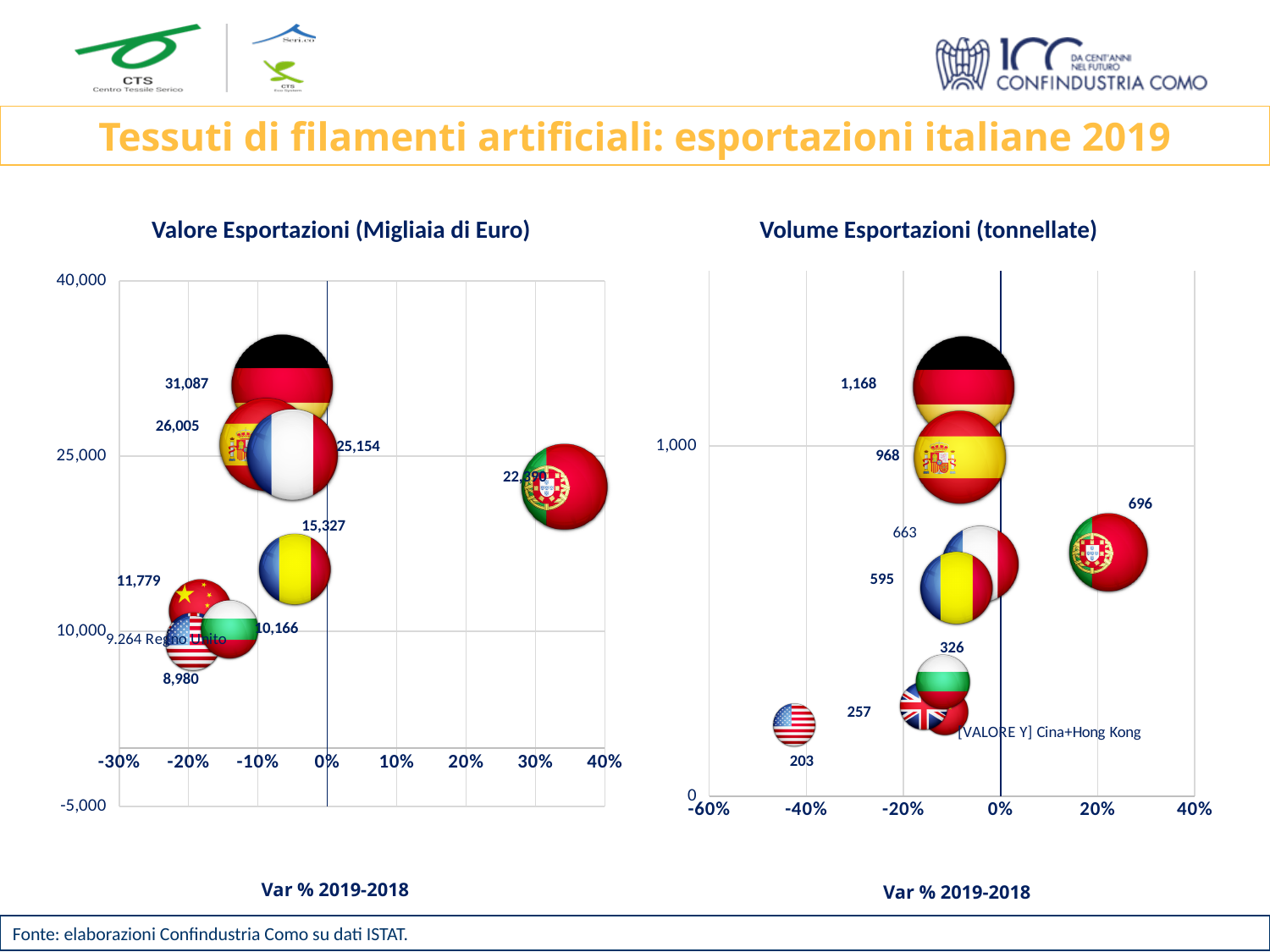
In the 'Volume Esportazioni (tonnellate)' chart, what is the highest labelled value? 1,168 What kind of chart is the 'Valore Esportazioni (Migliaia di Euro)' chart? Bubble chart In the 'Valore Esportazioni (Migliaia di Euro)' chart, what value is labelled for Regno Unito? 9.264 In the 'Valore Esportazioni (Migliaia di Euro)' chart, is the x-axis position of the bubble labelled 22,390 greater or less than 20%? greater In the 'Valore Esportazioni (Migliaia di Euro)' chart, what is the lowest labelled value? 8,980 In the 'Valore Esportazioni (Migliaia di Euro)' chart, what is the highest labelled value? 31,087 How many labelled data points are shown in the 'Valore Esportazioni (Migliaia di Euro)' chart? 9 In the 'Valore Esportazioni (Migliaia di Euro)' chart, what is the difference between the two highest labelled values, 31,087 and 26,005? 5,082 In the 'Valore Esportazioni (Migliaia di Euro)' chart, which is larger: the value labelled 25,154 or the value labelled 22,390? 25,154 In the 'Volume Esportazioni (tonnellate)' chart, what is the lowest labelled value? 203 In the 'Volume Esportazioni (tonnellate)' chart, what is the difference between the labelled values 1,168 and 968? 200 What is the x-axis label of the 'Volume Esportazioni (tonnellate)' chart? Var % 2019-2018